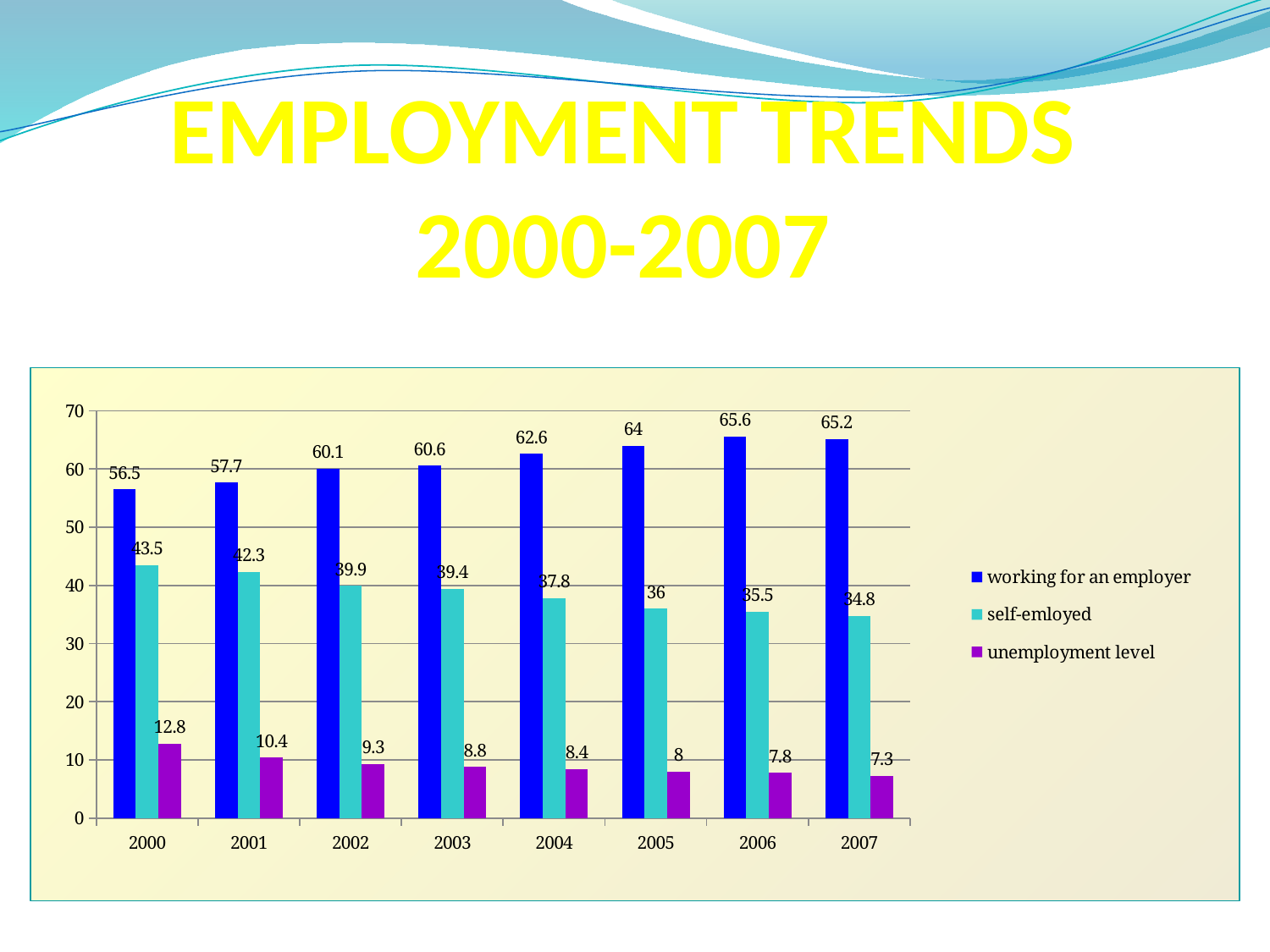
In which year is the 'working for an employer' value highest? 2006 In which year is the 'unemployment level' value lowest? 2007 Does the 'self-emloyed' value rise or fall from 2000 to 2007? fall Which is larger: the 'self-emloyed' value in 2001 or in 2005? 2001 How many series does the legend list? 3 What is the difference between the 'working for an employer' values in 2007 and 2000? 8.7 Is the 'unemployment level' value for 2000 greater or less than 10? greater What is the value for 'self-emloyed' in 2004? 37.8 What is the 'unemployment level' value in 2007? 7.3 What kind of chart is shown on the slide? bar chart What is the value for 'working for an employer' in 2000? 56.5 How many years are shown on the x axis? 8